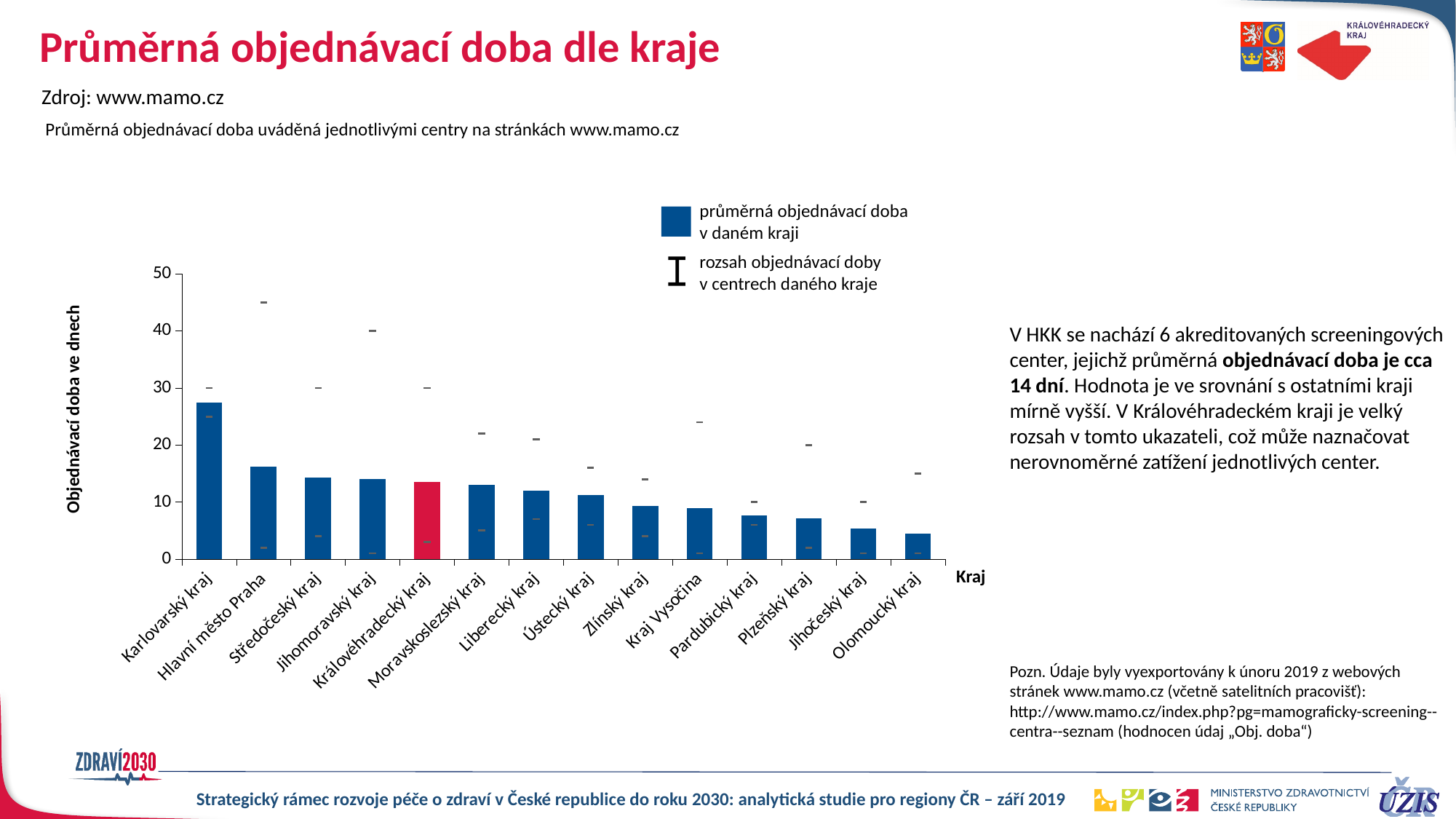
Is the average ordering time for Hlavní město Praha greater or less than 20 days? less How many regions are plotted on the x axis? 14 Is the average ordering time for Karlovarský kraj greater or less than 20 days? greater How many entries does the legend list? 2 Do the bar values rise or fall from left to right along the x axis? fall Is the average ordering time for Olomoucký kraj greater or less than 10 days? less Which region (kraj) has the lowest average ordering time? Olomoucký kraj Which region (kraj) has the highest average ordering time? Karlovarský kraj What type of chart is shown on the slide? bar chart Which region's bar is highlighted in red? Královéhradecký kraj Which has a higher average ordering time, Karlovarský kraj or Hlavní město Praha? Karlovarský kraj Which has a higher average ordering time, Zlínský kraj or Jihočeský kraj? Zlínský kraj